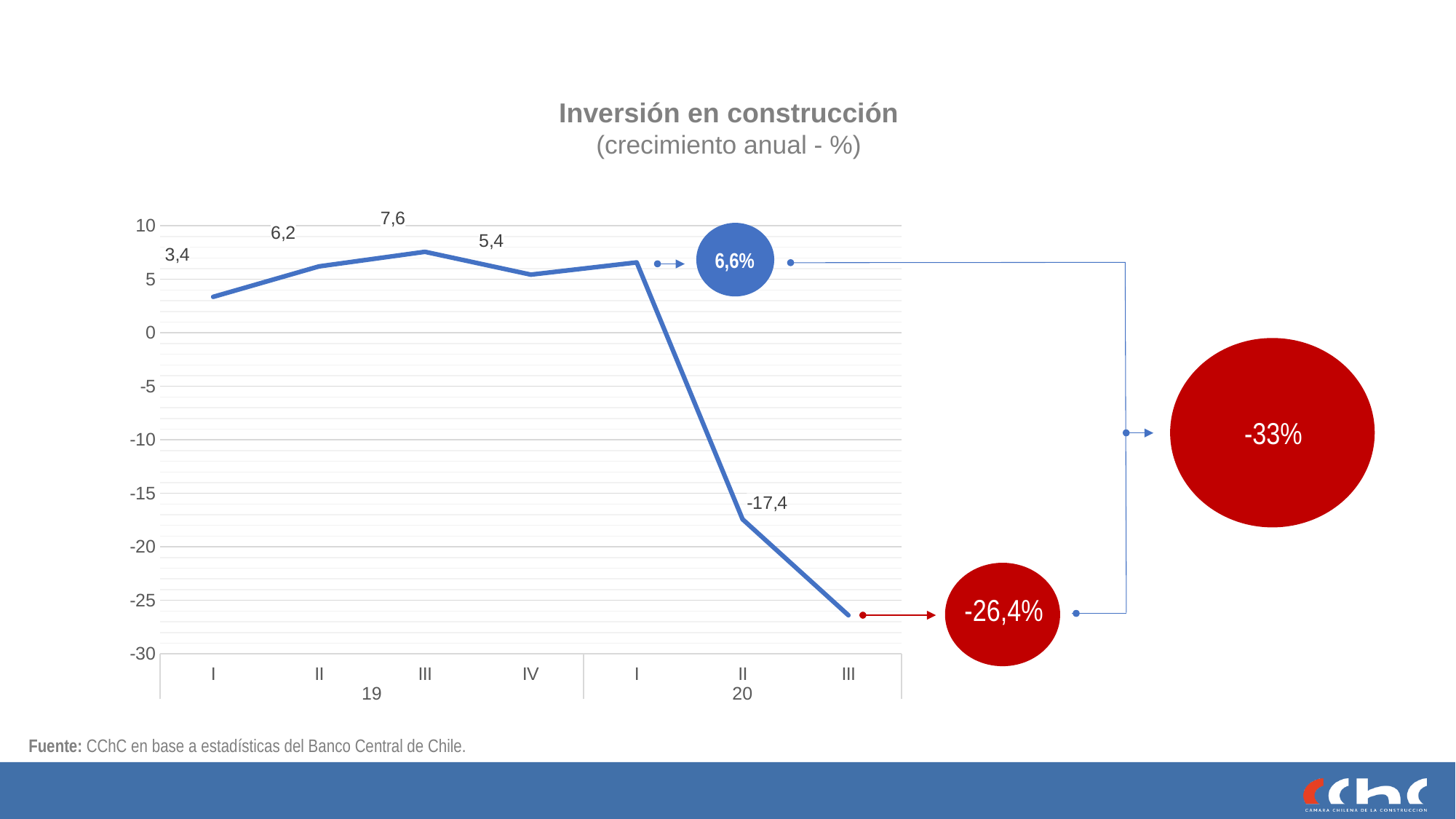
What kind of chart is shown? Line chart What is the value for quarter I of 2019? 3,4 What is the value for quarter III of 2019? 7,6 Do the values rise or fall from quarter I of 2020 to quarter III of 2020? Fall Which is larger, the value for quarter II of 2019 or quarter IV of 2019? II 2019 How many data points are plotted on the chart? 7 What is the value for quarter II of 2020? -17,4 Which quarter has the lowest value? III 2020 What value is shown for quarter I of 2020? 6,6% What value is shown for quarter III of 2020? -26,4% What is the difference between the values for quarter III of 2019 and quarter I of 2019? 4,2 Which quarter has the highest value? III 2019